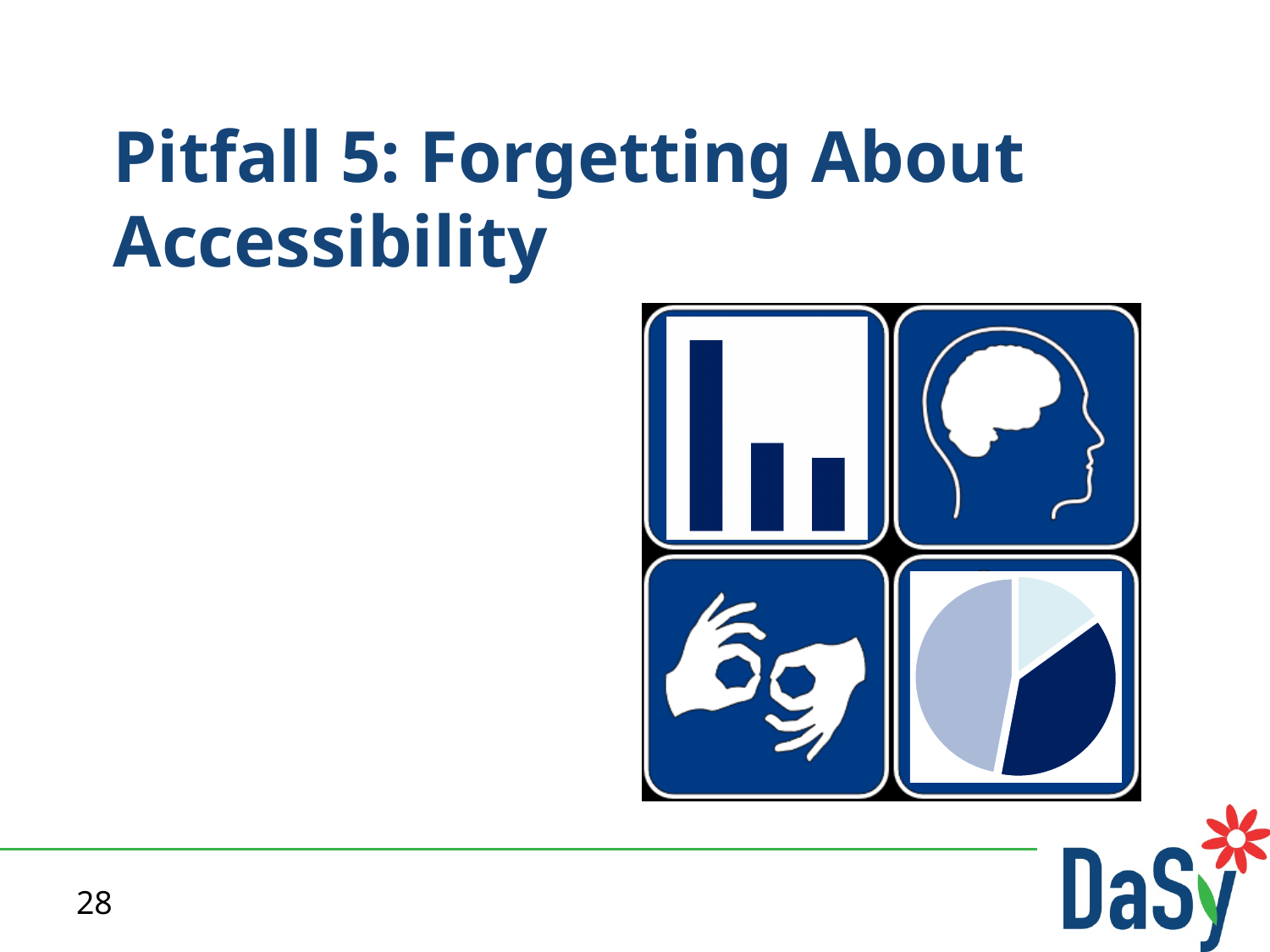
What kind of chart is shown in the top-left icon of the image? bar chart In the bottom-right pie chart icon, how many slices are there? 3 In the top-left bar chart icon, which bar is the shortest: the left, middle, or right one? right In the top-left bar chart icon, which bar is the tallest: the left, middle, or right one? left In the top-left bar chart icon, do the bars rise or fall from left to right? fall What kind of chart is shown in the bottom-right icon of the image? pie chart In the top-left bar chart icon, how many bars are there? 3 In the top-left bar chart icon, is the middle bar taller or shorter than the right bar? taller